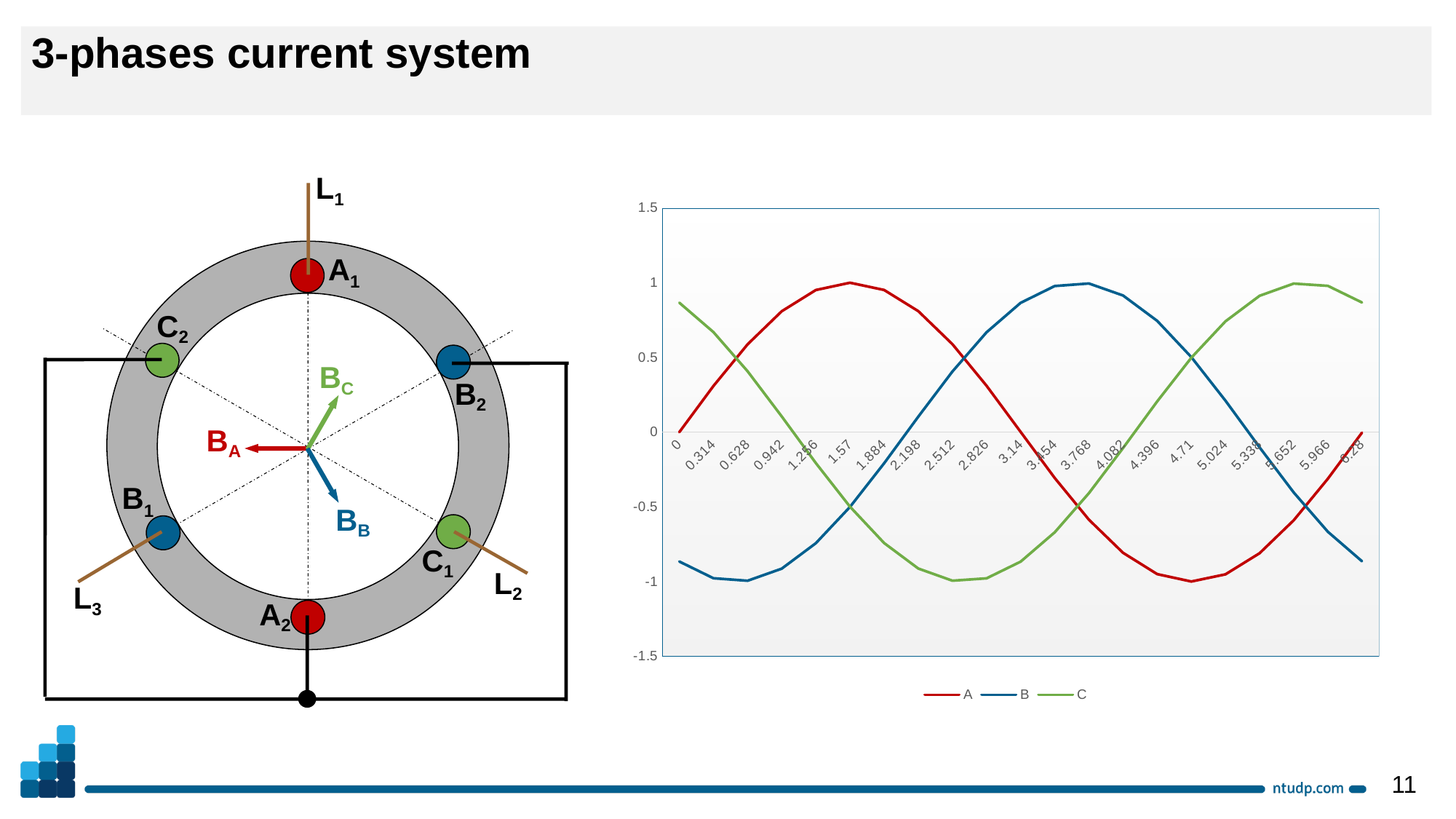
How many series does the legend of the line chart list? 3 How many x-axis tick labels does the line chart show? 21 What kind of chart is shown on the right side of the slide? line chart In the line chart, is the value of series C at x = 5.652 greater or less than 0.5? greater In the line chart, is the value of series B at x = 0.628 greater or less than -0.5? less What colour is series A drawn in on the line chart? red In the line chart, what is the value of series A at x = 0? 0 In the line chart, does series A rise or fall between x = 0 and x = 1.57? rise In the line chart, at x = 0, which series has the larger value, A or C? C In the line chart, what is the value of series A at x = 4.71? -1 In the line chart, at x = 3.14, which series has the larger value, B or C? B In the line chart, what is the value of series A at x = 1.57? 1